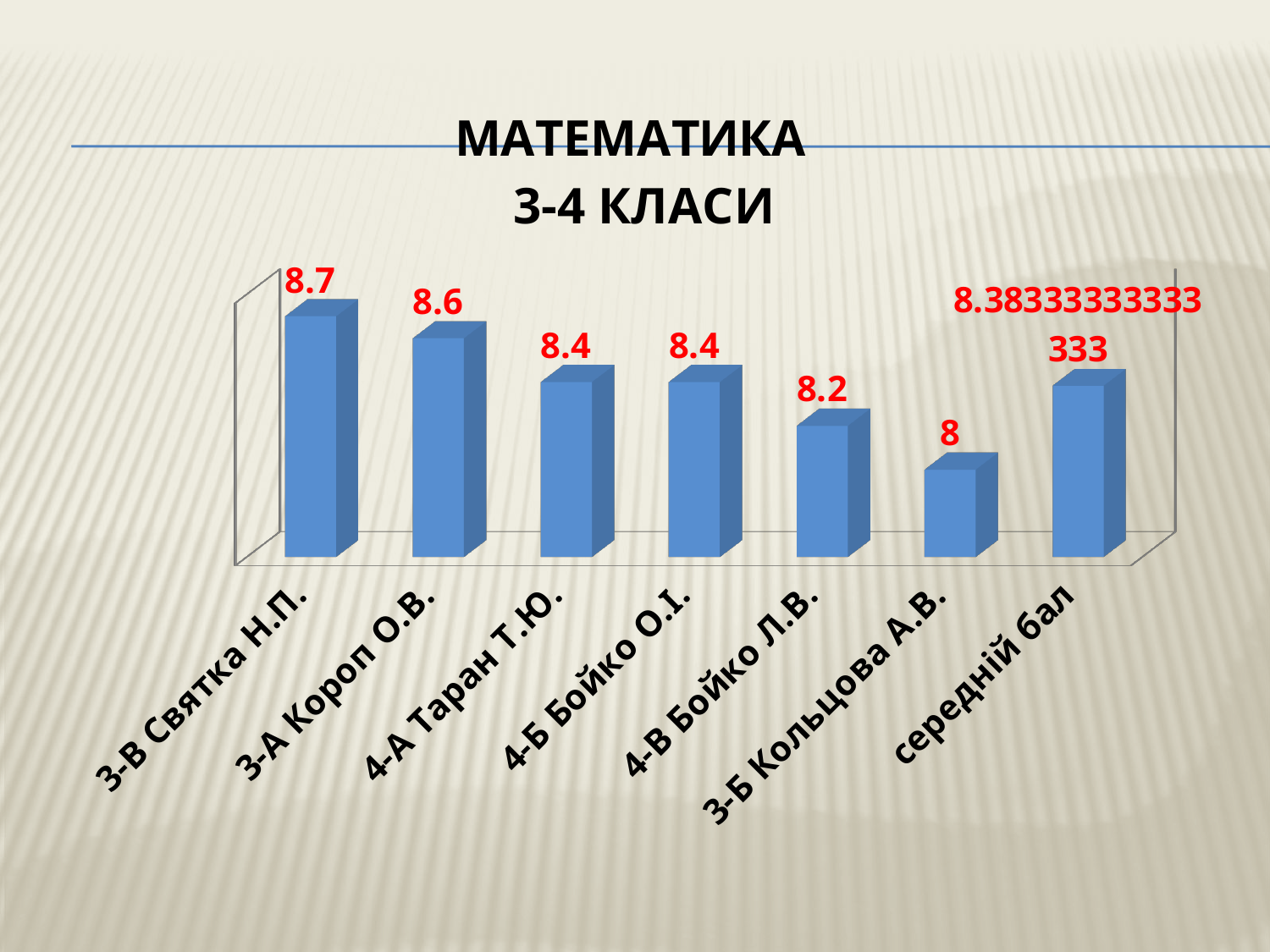
How many bars are shown in the chart? 7 What is the value for 3-А Короп О.В.? 8.6 What is the value for 4-В Бойко Л.В.? 8.2 What value is shown for середній бал? 8.38333333333333 Which category has the highest value? 3-В Святка Н.П. What is the value for 3-Б Кольцова А.В.? 8 Which is larger, the value for 3-А Короп О.В. or the value for 4-В Бойко Л.В.? 3-А Короп О.В. What kind of chart is shown on the slide? Bar chart What is the value for 3-В Святка Н.П.? 8.7 Which category has the lowest value? 3-Б Кольцова А.В. What is the difference between the values for 3-В Святка Н.П. and 3-Б Кольцова А.В.? 0.7 What is the title of the slide? МАТЕМАТИКА 3-4 КЛАСИ